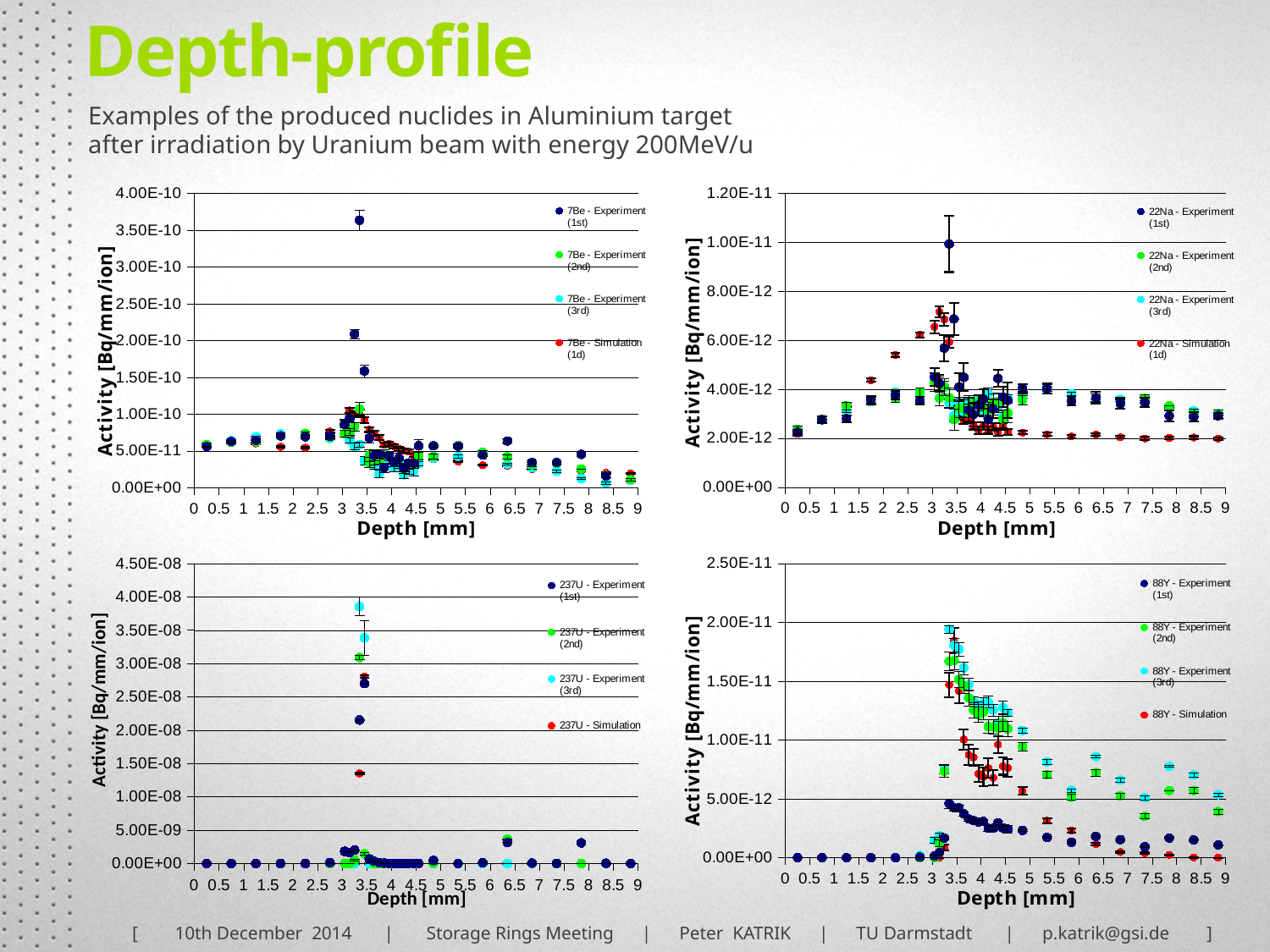
In the bottom-left chart (237U), is the peak value of 237U - Simulation greater or less than 1.50E-08? less In the bottom-right chart (88Y), is the value of 88Y - Simulation at a depth of 9 mm greater or less than 5.00E-12? less In the top-right chart (22Na), is the peak value of 22Na - Experiment (1st) greater or less than 8.00E-12? greater In the bottom-left chart (237U), which series reaches the highest activity value? 237U - Experiment (3rd) What is the y-axis title of the top-left chart (7Be)? Activity [Bq/mm/ion] What kind of chart is the top-left chart (7Be)? scatter chart How many series does the legend of the top-right chart (22Na) list? 4 What is the x-axis title of the bottom-right chart (88Y)? Depth [mm] In the top-left chart (7Be), which series reaches the highest activity value? 7Be - Experiment (1st) In the top-right chart (22Na), do the values of 22Na - Simulation rise or fall between a depth of 3.5 mm and 9 mm? fall